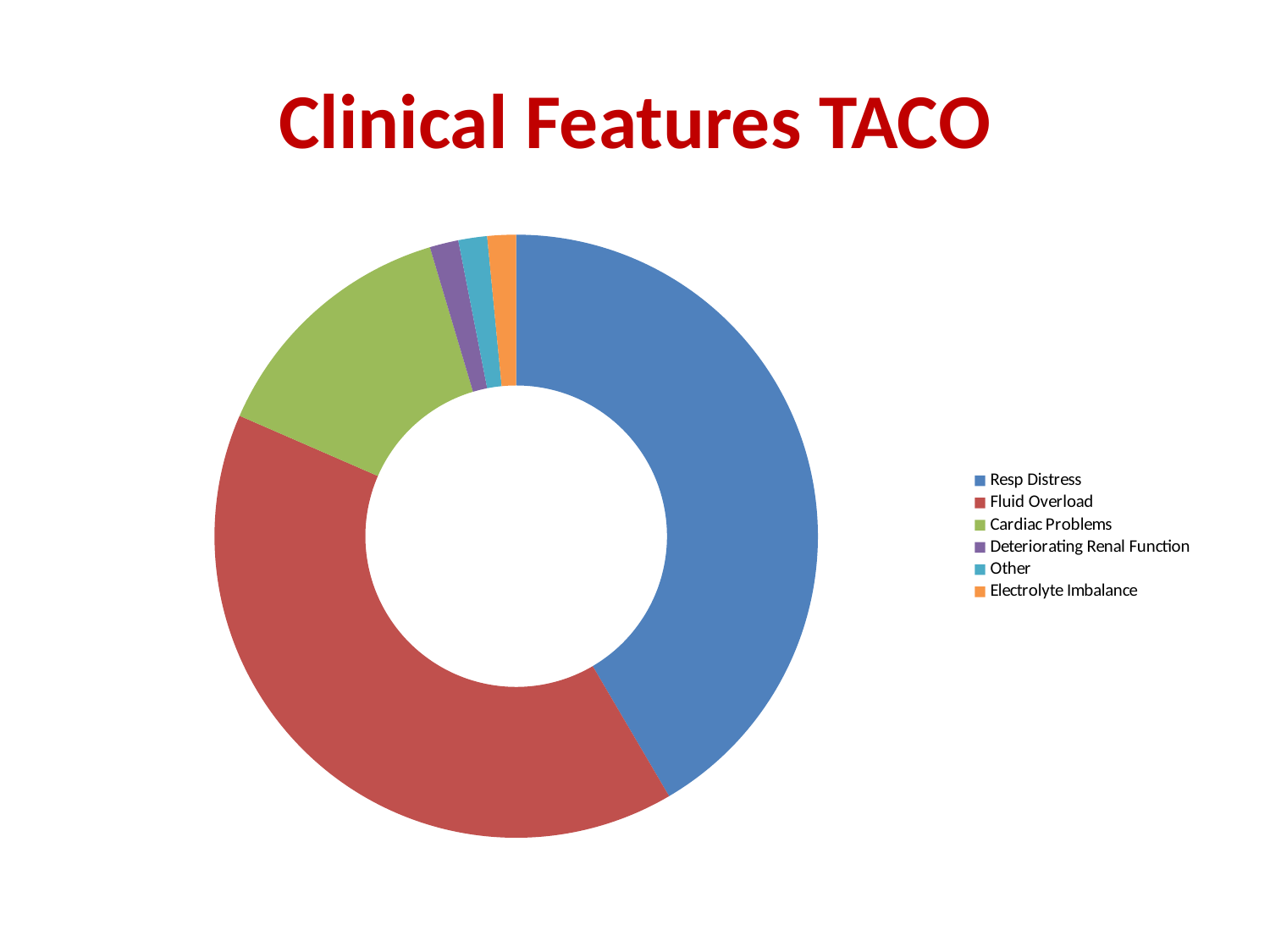
What kind of chart is shown on the slide? Doughnut (pie) chart How many categories does the chart show? 6 Which is larger, the slice for Resp Distress or the slice for Deteriorating Renal Function? Resp Distress How many entries does the legend list? 6 Which is larger, the slice for Cardiac Problems or the slice for Other? Cardiac Problems Which is larger, the slice for Fluid Overload or the slice for Cardiac Problems? Fluid Overload Which category is shown in blue? Resp Distress What is the title of the slide? Clinical Features TACO